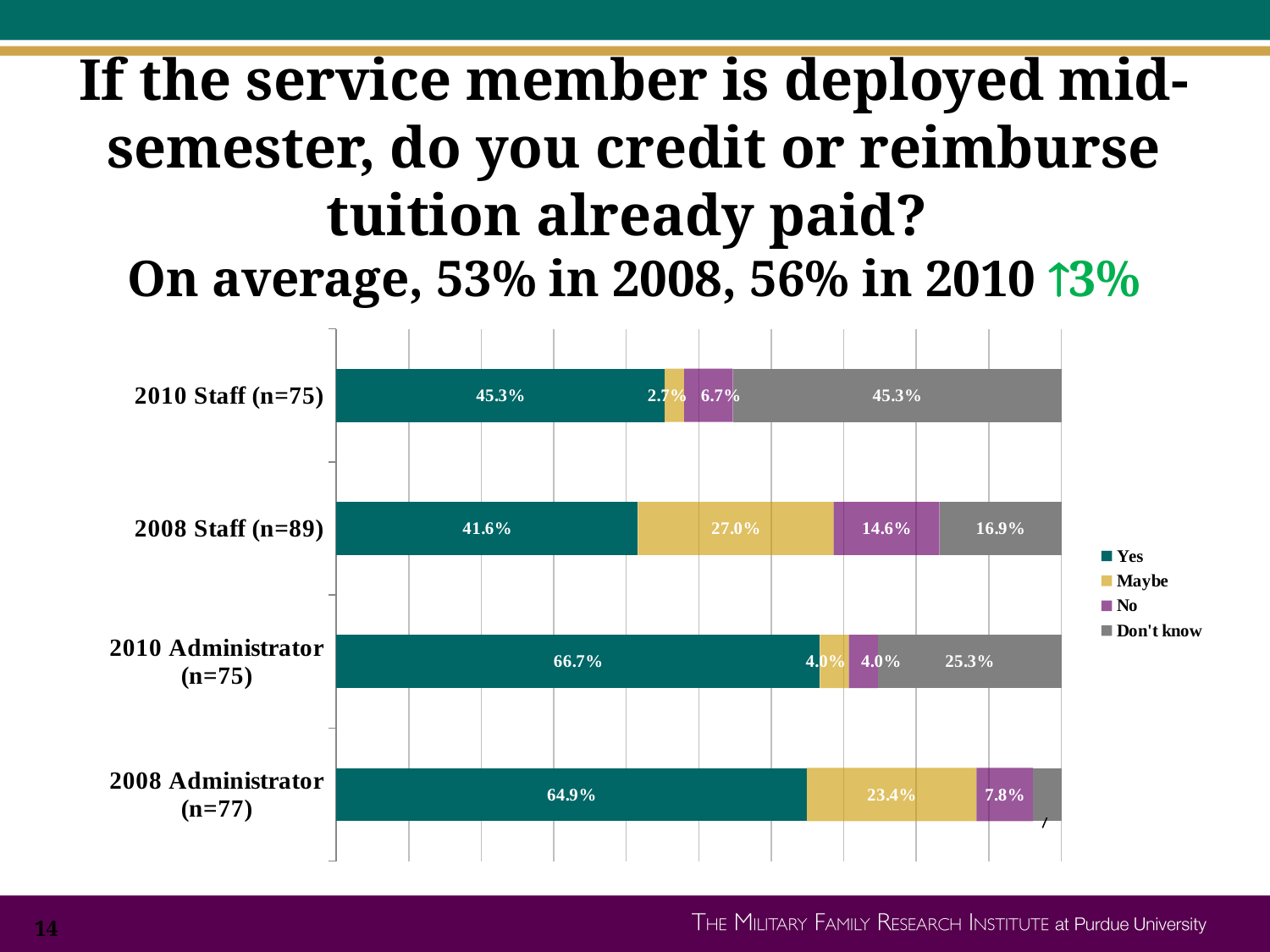
What percentage of 2008 Staff (n=89) answered Maybe? 27.0% What percentage of 2008 Administrators (n=77) answered No? 7.8% Which group has the lowest Yes percentage? 2008 Staff (n=89) What percentage of 2010 Administrators (n=75) answered Yes? 66.7% What type of chart is shown on the slide? Stacked bar chart How many groups (bars) are shown in the chart? 4 What is the difference between the Yes percentage for 2010 Administrators and 2008 Administrators? 1.8% How many series does the legend list? 4 Which response category is shown in grey in the legend? Don't know What percentage of 2010 Staff (n=75) answered Don't know? 45.3% Which group has the highest Yes percentage? 2010 Administrator (n=75) Which is larger: the No percentage for 2008 Staff or the No percentage for 2010 Staff? 2008 Staff